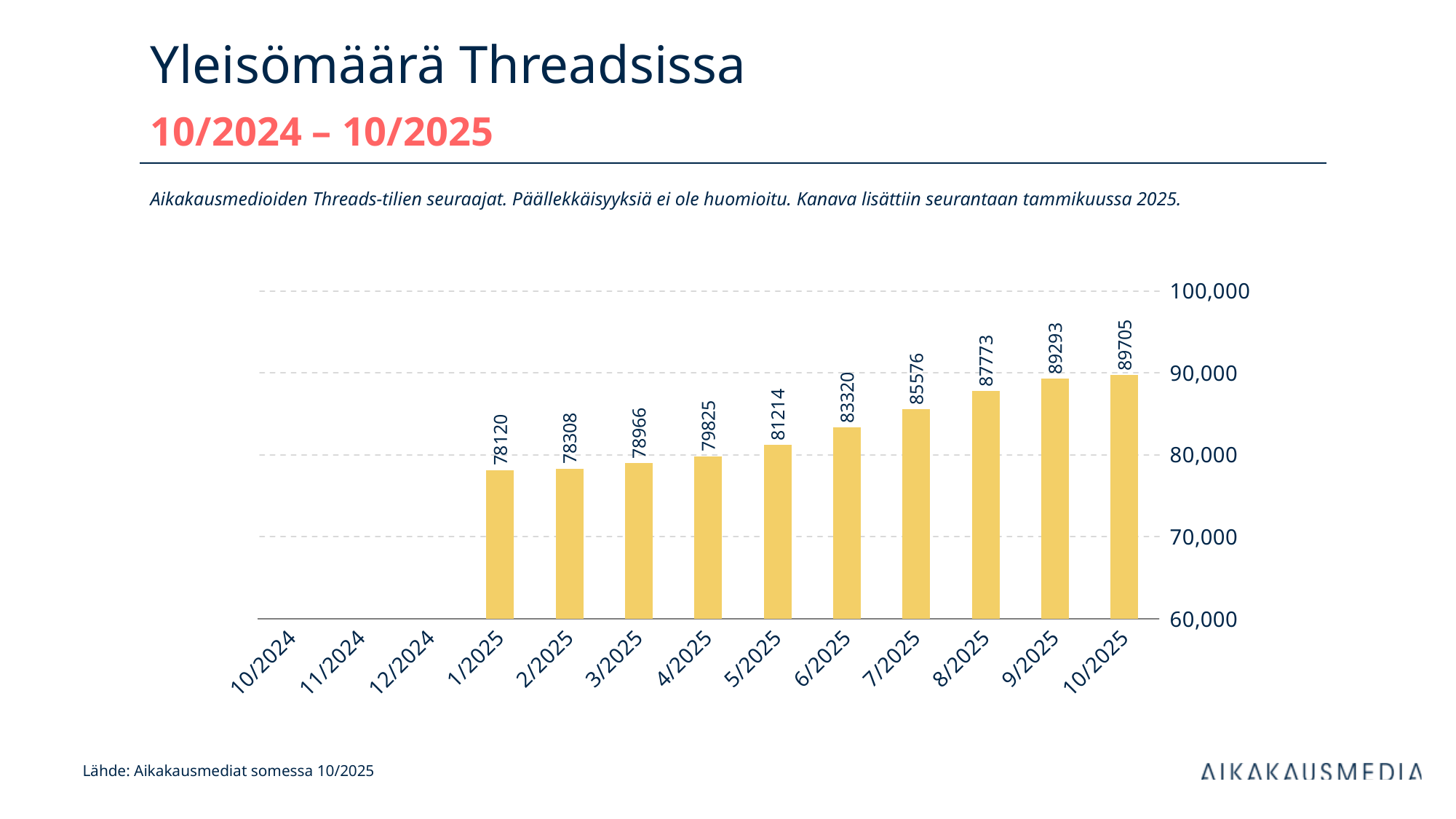
Do the values rise or fall from 1/2025 to 10/2025? rise What kind of chart is shown? bar chart Which month has the highest value? 10/2025 Which month with a bar has the lowest value? 1/2025 Is the value for 7/2025 greater or less than 90,000? less What is the value for 10/2025? 89705 What is the difference between the values for 9/2025 and 8/2025? 1520 How many months have a bar plotted? 10 Which is larger, the value for 5/2025 or the value for 4/2025? 5/2025 What is the value for 6/2025? 83320 What is the difference between the values for 10/2025 and 1/2025? 11585 What is the value for 1/2025? 78120